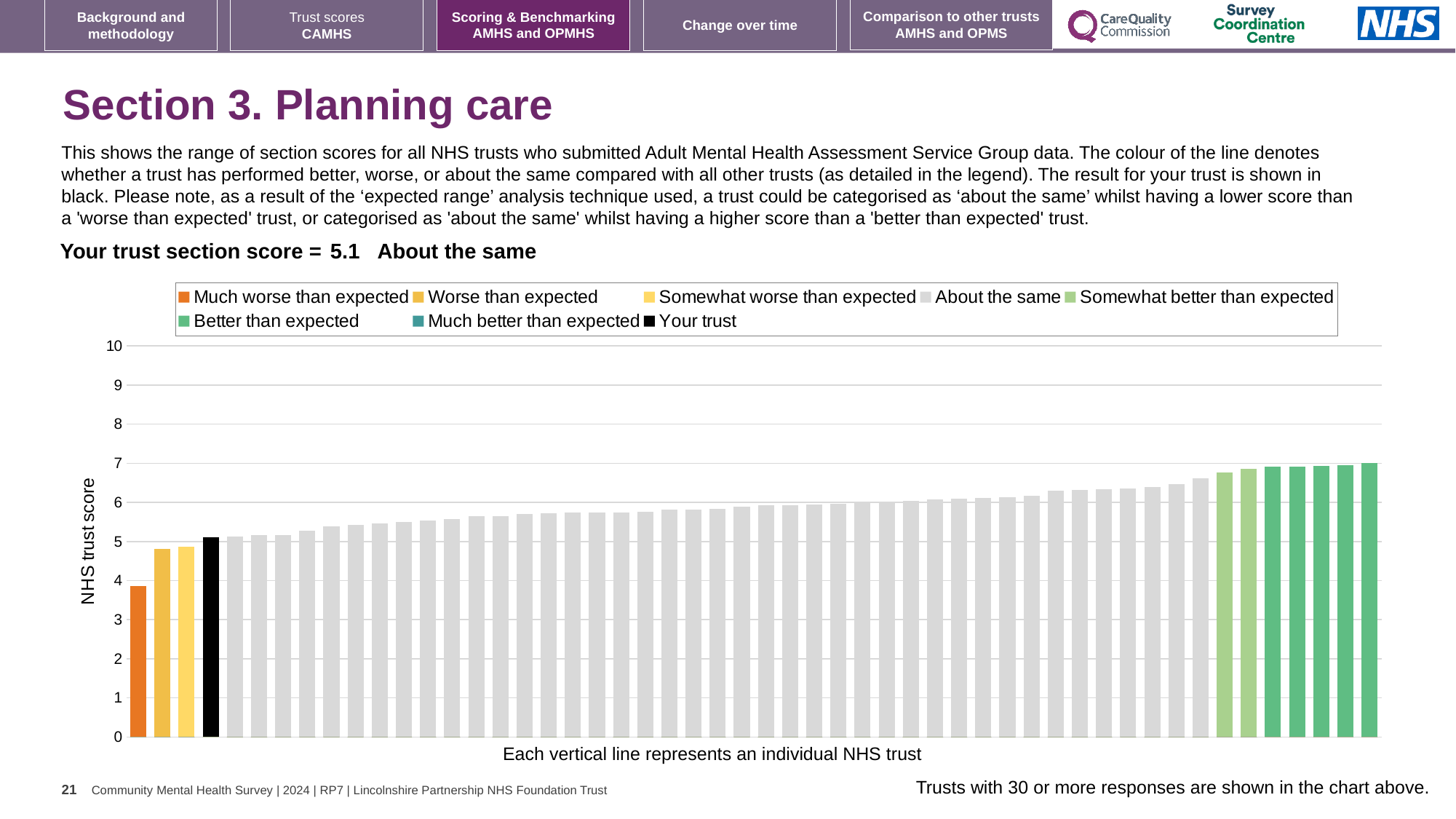
Is the value of the black 'Your trust' bar greater or less than 5? greater Which legend category does the highest bar in the chart belong to? Better than expected What kind of chart is shown on the slide? Bar chart Is the 'Your trust' bar higher or lower than the orange 'Much worse than expected' bar? higher Which legend category does the lowest bar in the chart belong to? Much worse than expected Is the value of the highest bar in the chart greater or less than 6? greater Which benchmarking category is your trust placed in for this section? About the same Do the bar values rise or fall from left to right across the chart? rise Is the value of the lowest bar in the chart greater or less than 4? less How many entries does the chart legend list? 8 What is the label on the vertical axis of the chart? NHS trust score What is the section score for your trust shown on the slide? 5.1